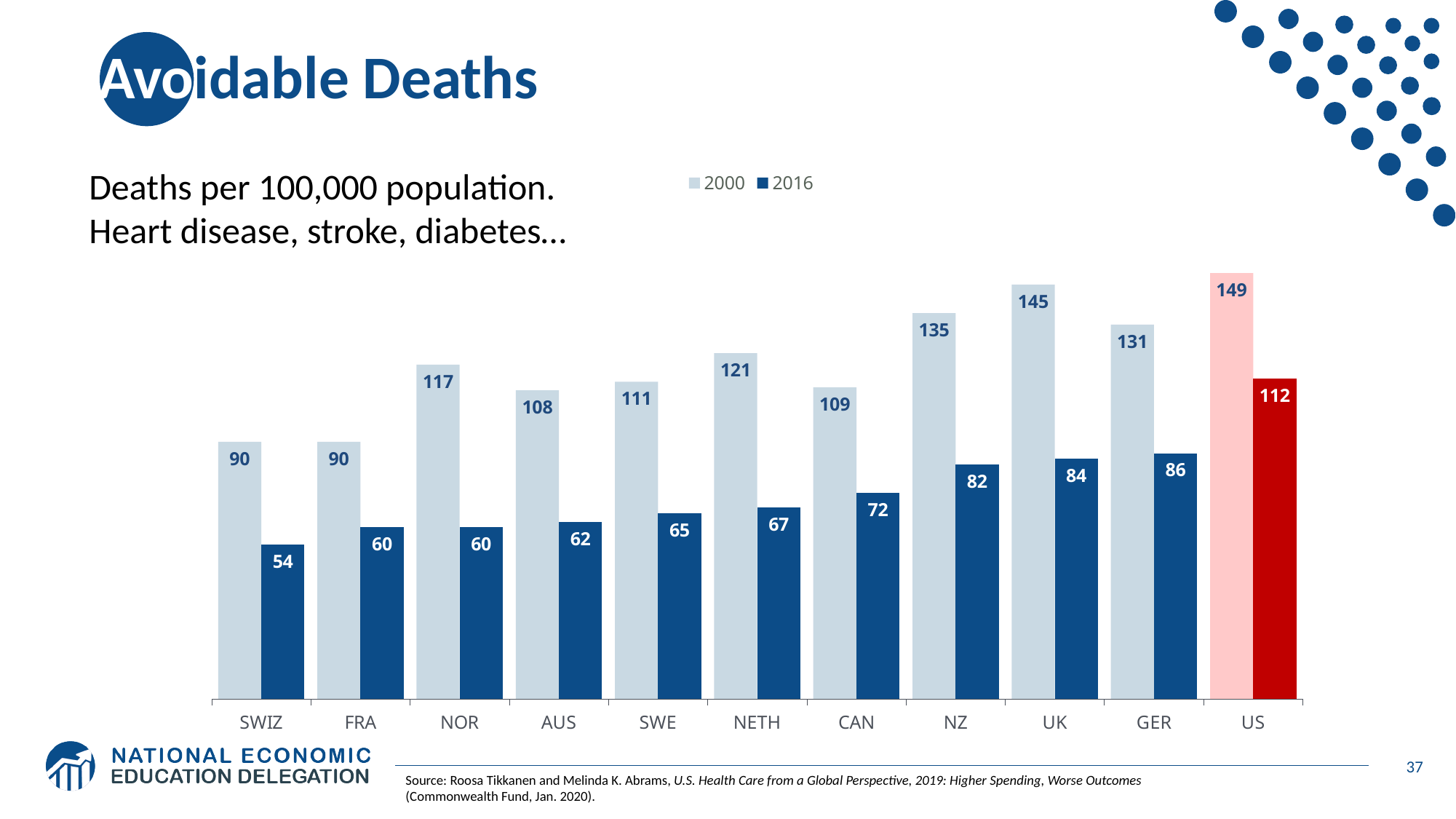
What is the 2016 value for the US? 112 What is the difference between the 2016 values for GER and SWIZ? 32 Which country has the lowest 2016 value? SWIZ Which country has the highest 2000 value? US What kind of chart is shown on the slide? bar chart How many series does the legend list? 2 Which two countries share the same 2000 value of 90? SWIZ and FRA What is the 2000 value for NOR? 117 How many countries are shown on the x axis? 11 Which country's bars are highlighted in red/pink rather than blue? US Which is larger, the 2016 value for NZ or the 2016 value for CAN? NZ What is the difference between the 2000 and 2016 values for the US? 37